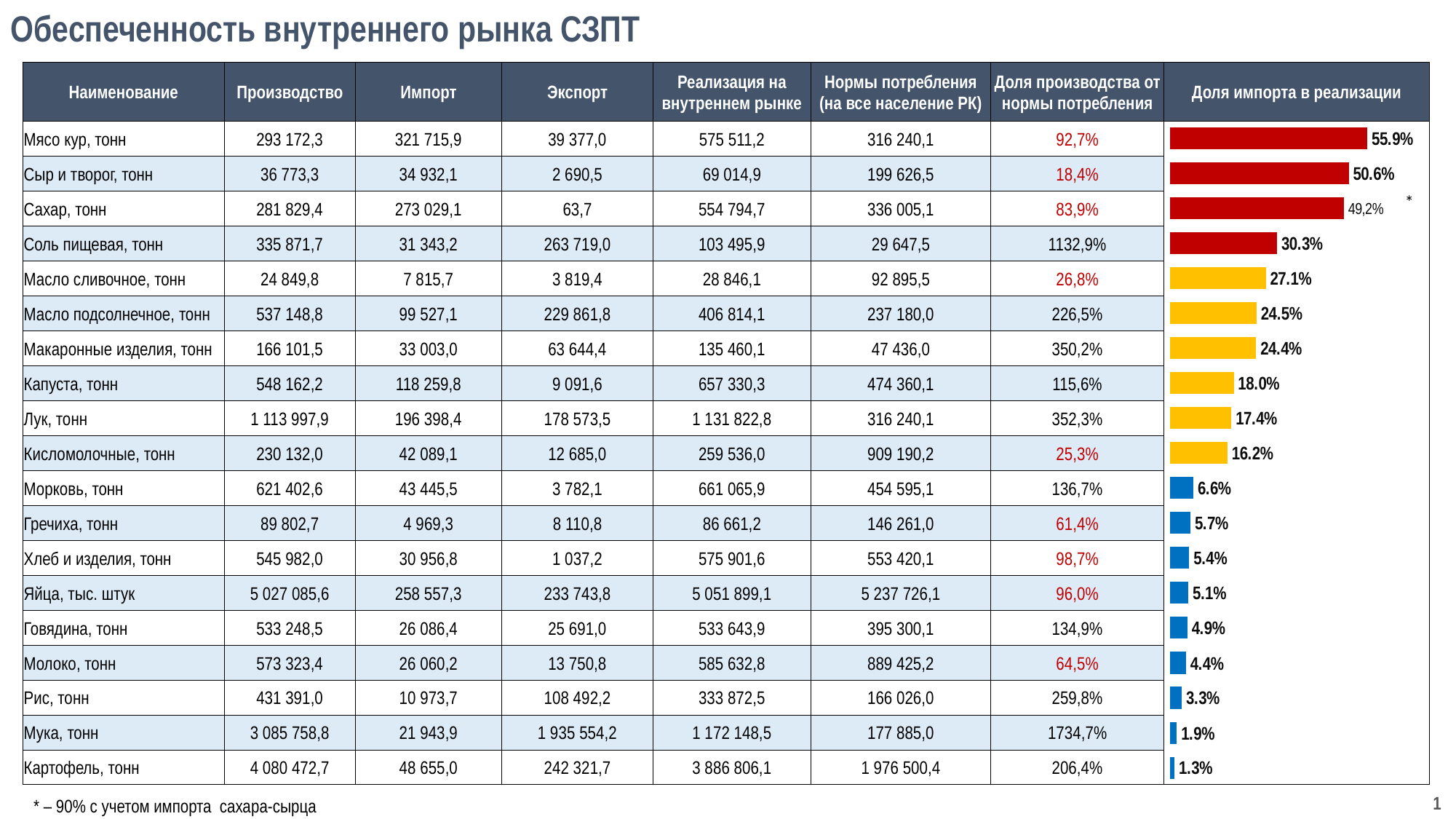
In the 'Доля импорта в реализации' chart, what is the value for Яйца, тыс. штук? 5.1% In the 'Доля импорта в реализации' chart, which category has the highest value? Мясо кур, тонн In the 'Доля импорта в реализации' chart, which is larger: the value for Капуста, тонн or for Лук, тонн? Капуста, тонн In the 'Доля импорта в реализации' chart, what is the value shown for Сахар, тонн? 49,2% In the 'Доля импорта в реализации' chart, which category has the lowest value? Картофель, тонн In the 'Доля импорта в реализации' chart, what colour is the bar for Масло сливочное, тонн? Yellow In the 'Доля импорта в реализации' chart, what is the value for Мясо кур, тонн? 55.9% In the 'Доля импорта в реализации' chart, what is the difference between the values for Морковь, тонн and Гречиха, тонн? 0.9% In the 'Доля импорта в реализации' chart, what is the difference between the values for Мясо кур, тонн and Сыр и творог, тонн? 5.3% What kind of chart is used in the 'Доля импорта в реализации' column? Bar chart How many categories (bars) are shown in the 'Доля импорта в реализации' chart? 19 In the 'Доля импорта в реализации' chart, what is the value for Соль пищевая, тонн? 30.3%